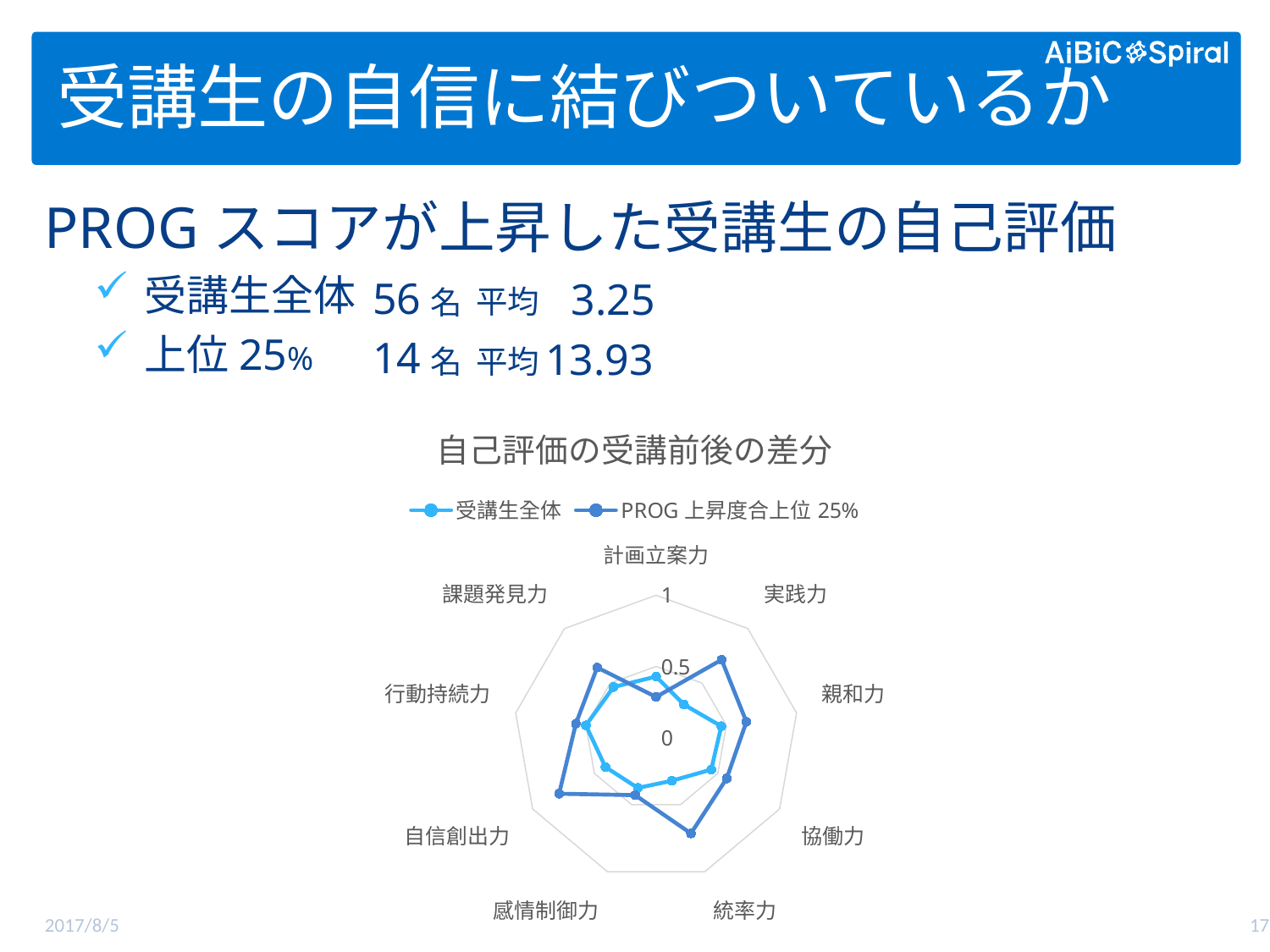
For 自信創出力, which series has the larger value, 受講生全体 or PROG 上昇度合上位 25%? PROG 上昇度合上位 25% Is the value for 計画立案力 in the 受講生全体 series greater or less than 0.5? less How many categories (axes) does the radar chart have? 9 What is the title of the chart? 自己評価の受講前後の差分 Is the value for 実践力 in the 受講生全体 series greater or less than 0.5? less Is the value for 統率力 in the PROG 上昇度合上位 25% series greater or less than 0.5? greater For 実践力, which series has the larger value, 受講生全体 or PROG 上昇度合上位 25%? PROG 上昇度合上位 25% What kind of chart is shown on the slide? radar chart In the PROG 上昇度合上位 25% series, which category has the highest value? 自信創出力 What are the two series named in the chart legend? 受講生全体 and PROG 上昇度合上位 25% How many series does the chart legend list? 2